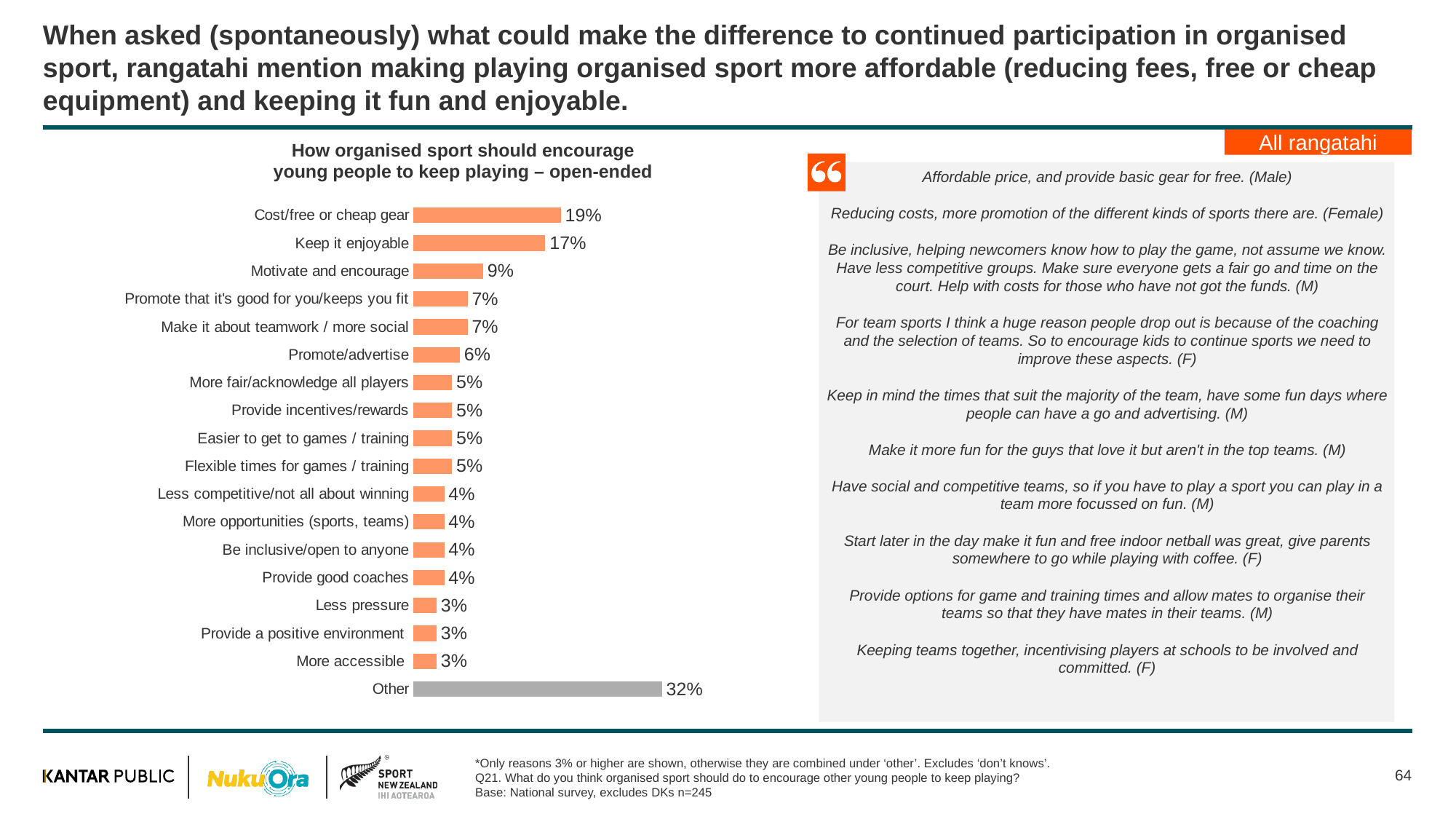
What is the value for 'Other' in the chart? 32% How many categories (bars) are shown in the chart, including 'Other'? 18 What type of chart is used on this slide? Bar chart What is the difference in percentage points between 'Cost/free or cheap gear' and 'Keep it enjoyable'? 2 Excluding 'Other', which category has the highest value in the chart? Cost/free or cheap gear What percentage is shown for 'Provide good coaches'? 4% What percentage of rangatahi mentioned 'Cost/free or cheap gear'? 19% What percentage is shown for 'Motivate and encourage'? 9% What is the value shown for 'Keep it enjoyable'? 17% What is the title of the chart on the slide? How organised sport should encourage young people to keep playing – open-ended Which bar in the chart has the largest value overall? Other Which has a higher value: 'Promote/advertise' or 'Motivate and encourage'? Motivate and encourage